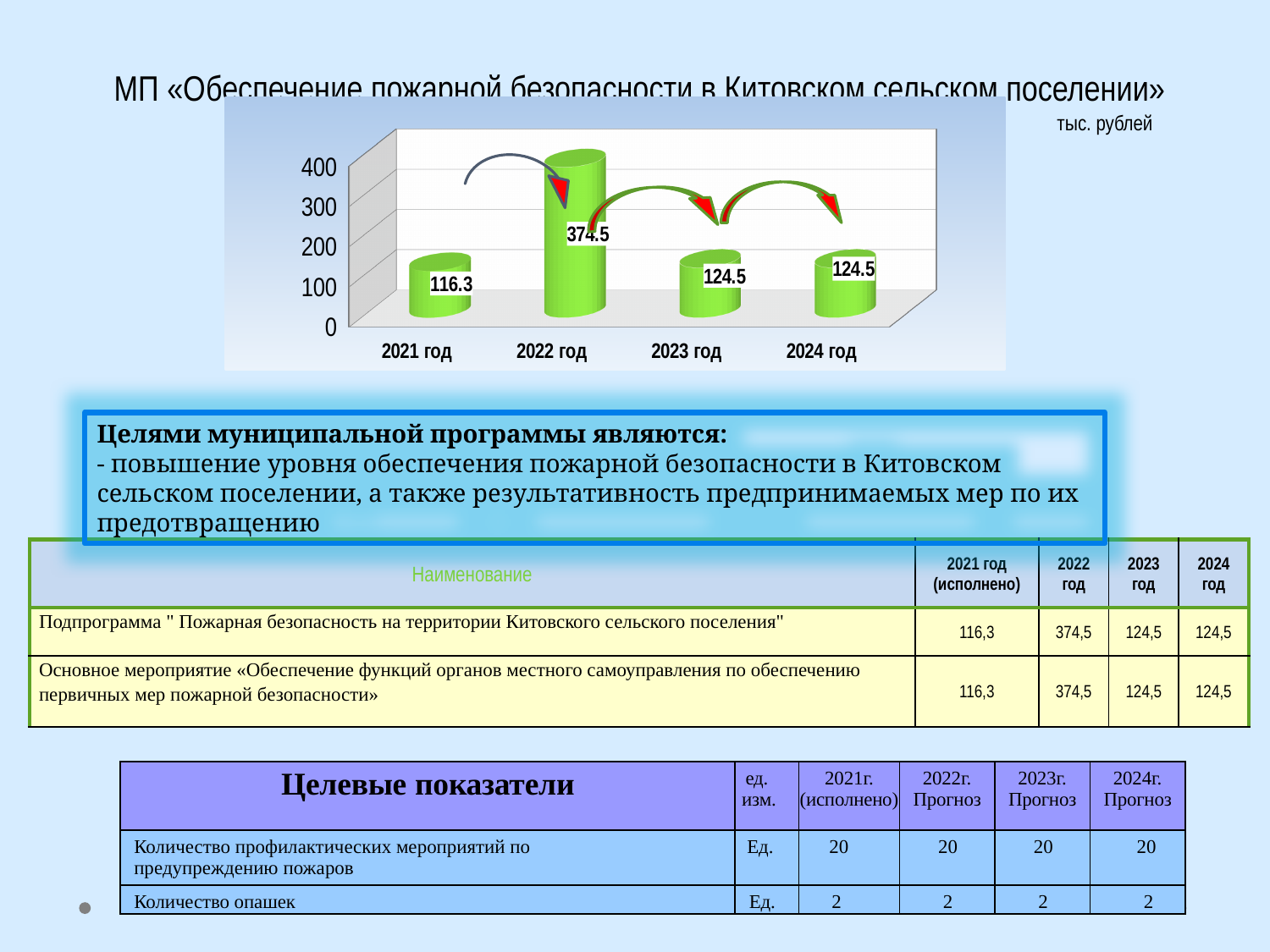
How many years are shown on the x axis of the chart? 4 What is the value for 2022 год in the chart? 374.5 Is the value for 2022 год greater or less than 300? greater Which is larger, the value for 2021 год or the value for 2024 год? 2024 год What is the difference between the values for 2023 год and 2021 год? 8.2 What kind of chart is shown on the slide? Bar chart Which year has the highest value in the chart? 2022 год What is the value for 2021 год in the chart? 116.3 What is the difference between the values for 2022 год and 2023 год? 250 In what units are the chart values given, according to the label above the chart? тыс. рублей What is the value for 2023 год in the chart? 124.5 Which year has the lowest value in the chart? 2021 год